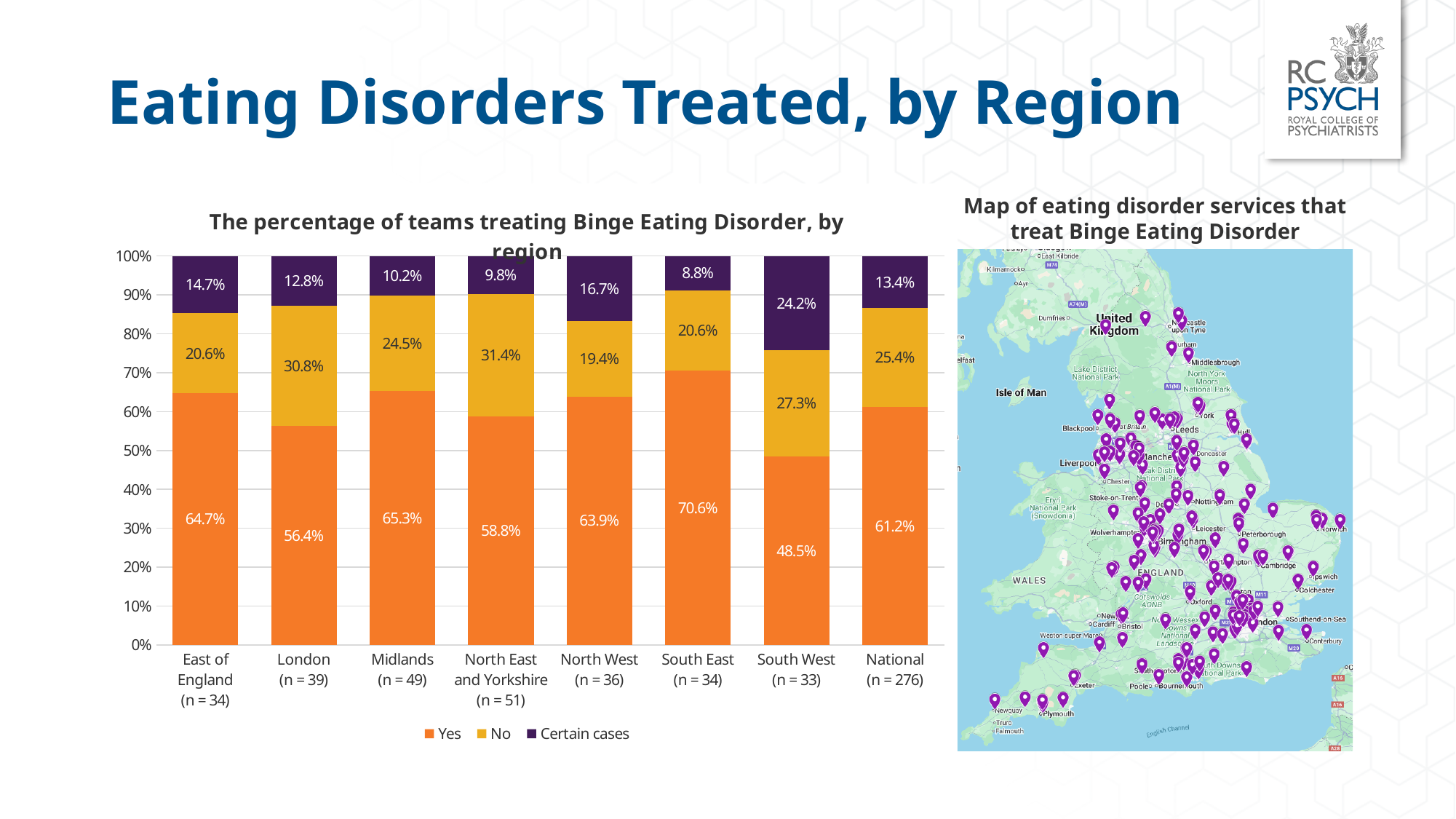
What is the 'No' percentage for London? 30.8% What is the National 'Yes' percentage? 61.2% What percentage of teams in the South East answered 'Yes' to treating Binge Eating Disorder? 70.6% What kind of chart is used to show the percentage of teams treating Binge Eating Disorder by region? Stacked bar chart How many region categories (including National) are shown on the x axis? 8 Which region has the highest 'Yes' percentage? South East What is the 'Certain cases' percentage for the South West? 24.2% Which region has the highest 'Certain cases' percentage? South West Which region has the lowest 'Yes' percentage? South West How many series does the legend list? 3 Which has a larger 'Yes' percentage, the Midlands or London? Midlands What is the difference in percentage points between the 'Yes' values for the South East and the South West? 22.1 percentage points